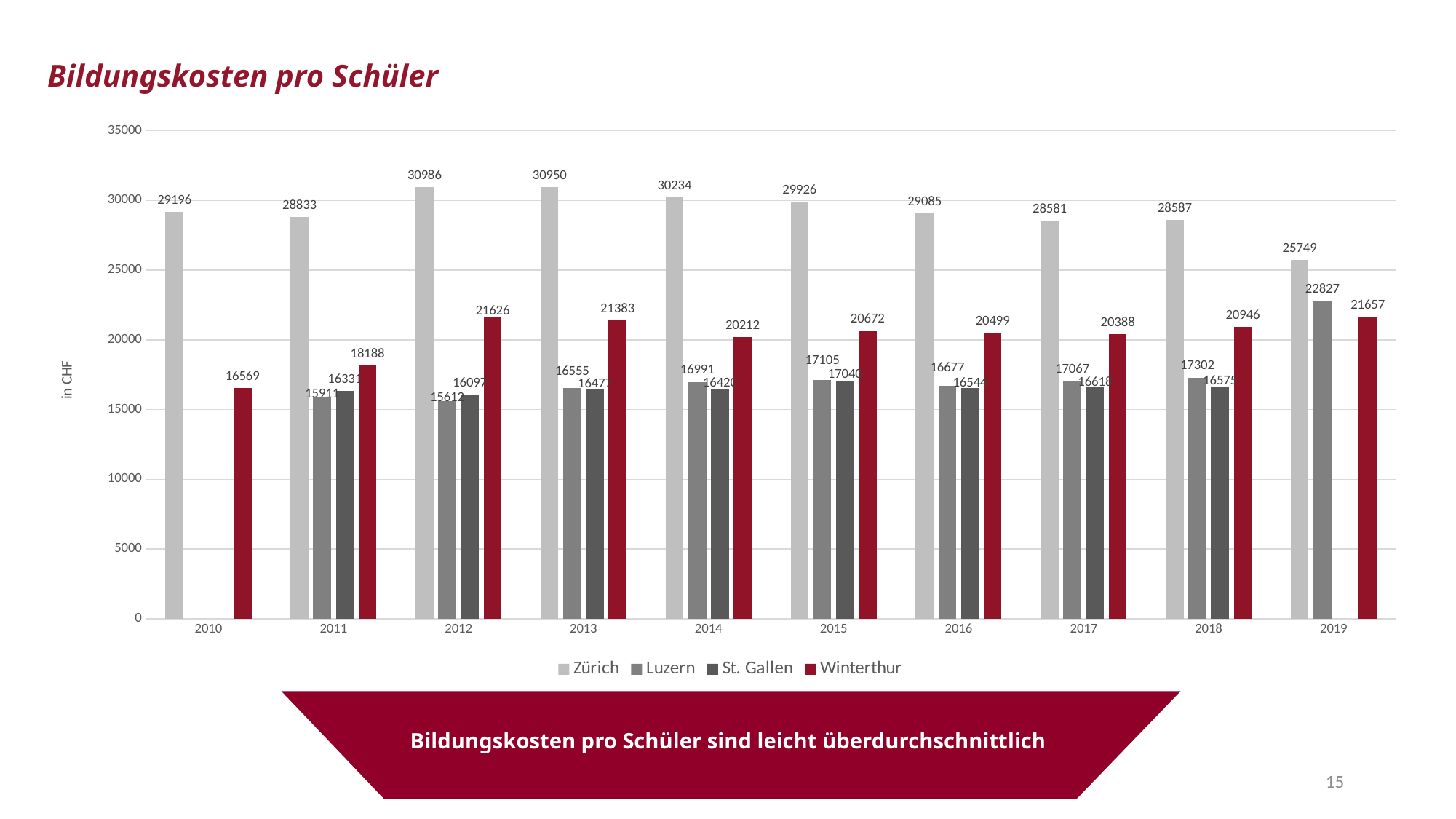
What is the difference between the Zürich and Winterthur values in 2019? 4092 What is the value for Winterthur in 2019? 21657 What kind of chart is shown on the slide? bar chart Is the value for Zürich in 2010 greater or less than 25000? greater What is the value for Zürich in 2012? 30986 Which is larger in 2019, the value for Luzern or the value for Winterthur? Luzern By how much did the Winterthur value increase from 2011 to 2012? 3438 How many years are shown on the x axis? 10 In which year is the value for Zürich the highest? 2012 In which year is the value for Winterthur the lowest? 2010 How many series does the legend list? 4 What is the value for Luzern in 2018? 17302